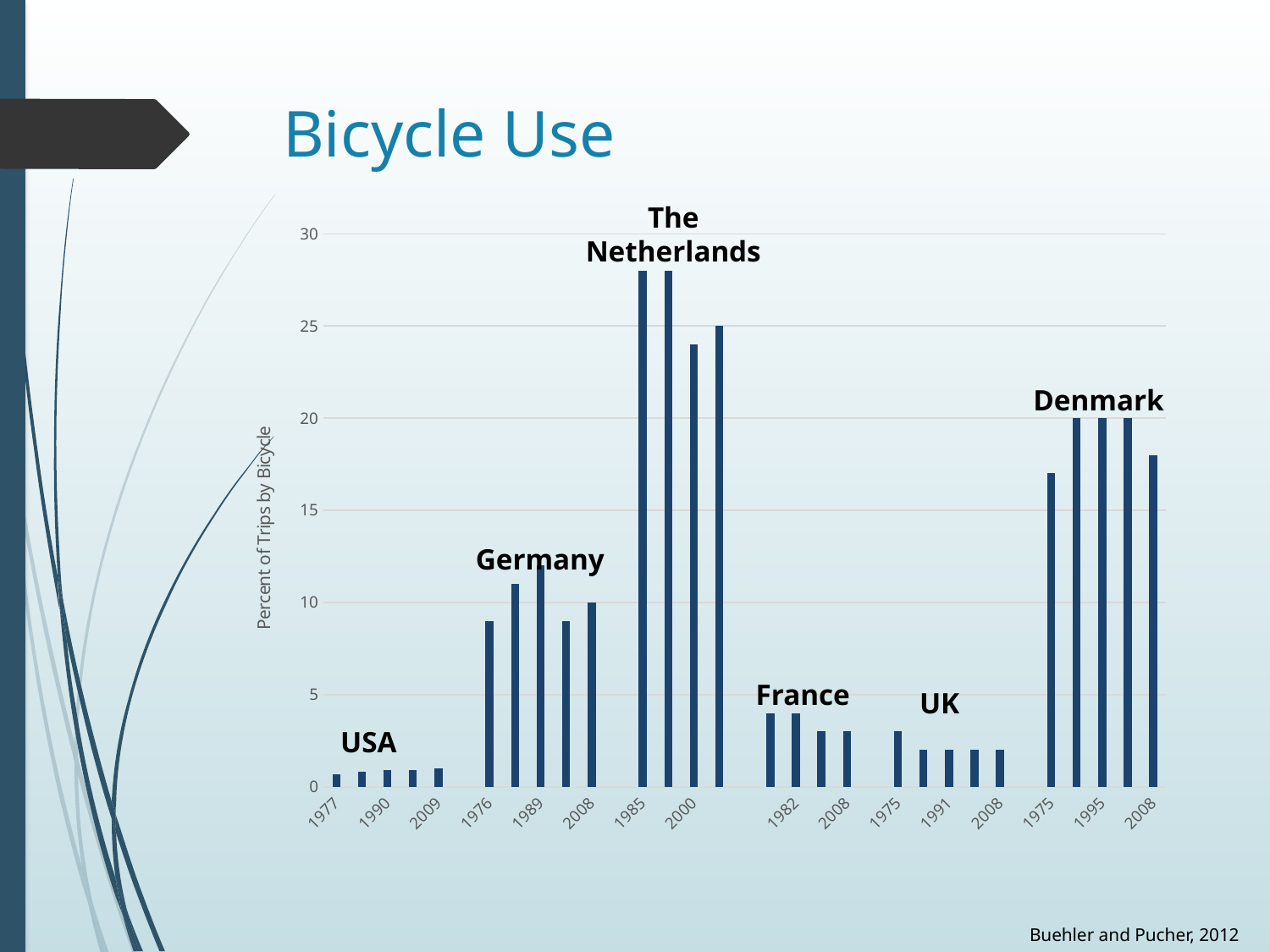
What is the percent of trips by bicycle for Denmark in 1995? 20 Is the value for The Netherlands in 1985 greater or less than 25? greater Which country has the highest percent of trips by bicycle? The Netherlands Is the value for Denmark in 1975 greater or less than 15? greater What is the label on the vertical axis? Percent of Trips by Bicycle What is the percent of trips by bicycle for Germany in 2008? 10 Which is larger, the value for The Netherlands in 1985 or the value for Denmark in 1995? The Netherlands in 1985 Do the UK values rise or fall from 1975 to 2008? fall What kind of chart is shown on the slide? bar chart Which country has the lowest percent of trips by bicycle? USA How many countries are shown in the chart? 6 Is the value for the USA in 1977 greater or less than 5? less